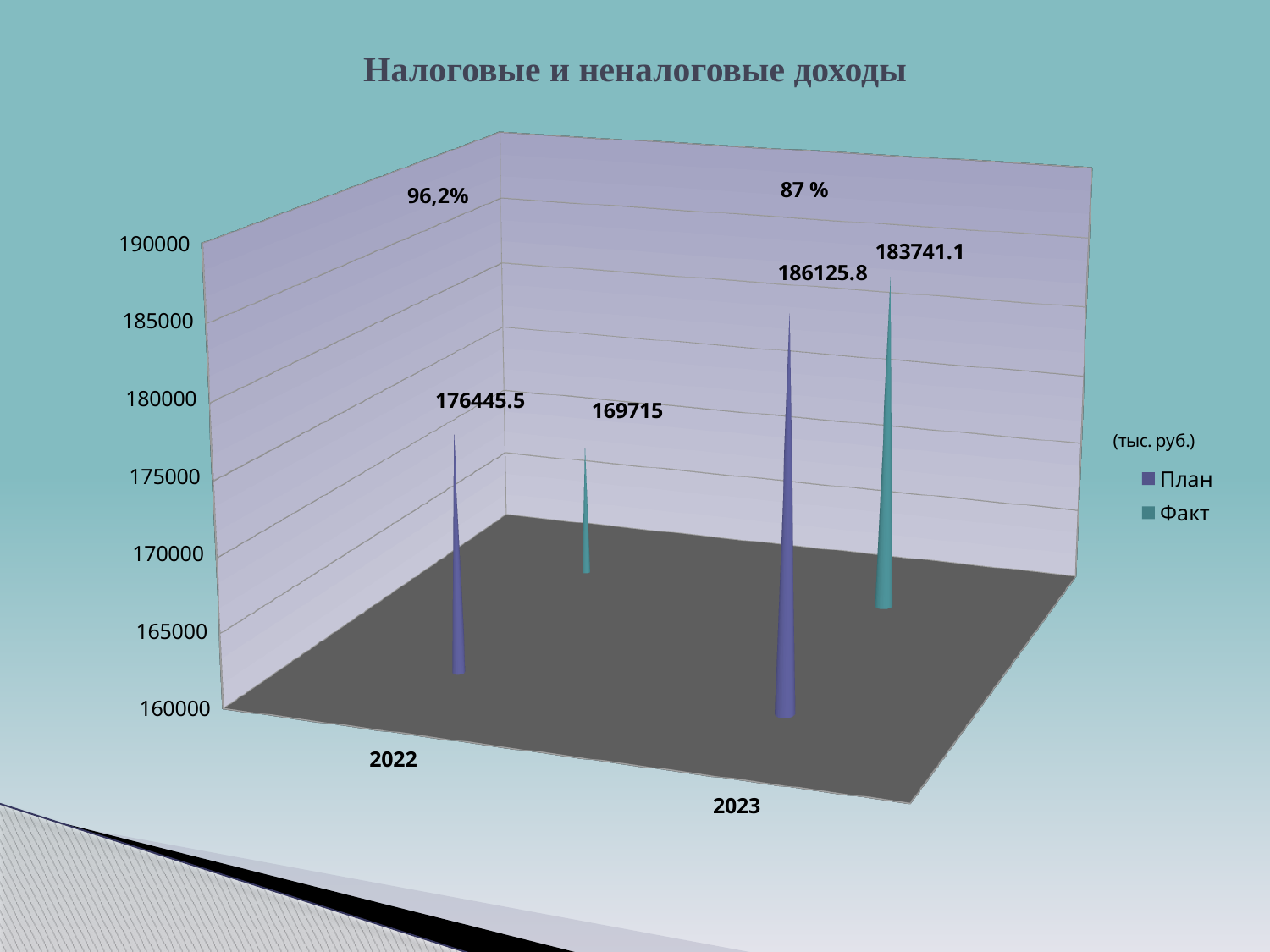
Which year has the lower Факт value? 2022 How many years are shown on the x axis? 2 What is the difference between the План and Факт values for 2022? 6730.5 What is the Факт value for 2022? 169715 What is the Факт value for 2023? 183741.1 What is the difference between the План and Факт values for 2023? 2384.7 What is the План value for 2022? 176445.5 Which is larger for 2023, План or Факт? План Which year has the higher План value? 2023 What is the title of the chart? Налоговые и неналоговые доходы What is the План value for 2023? 186125.8 How many series does the legend list? 2